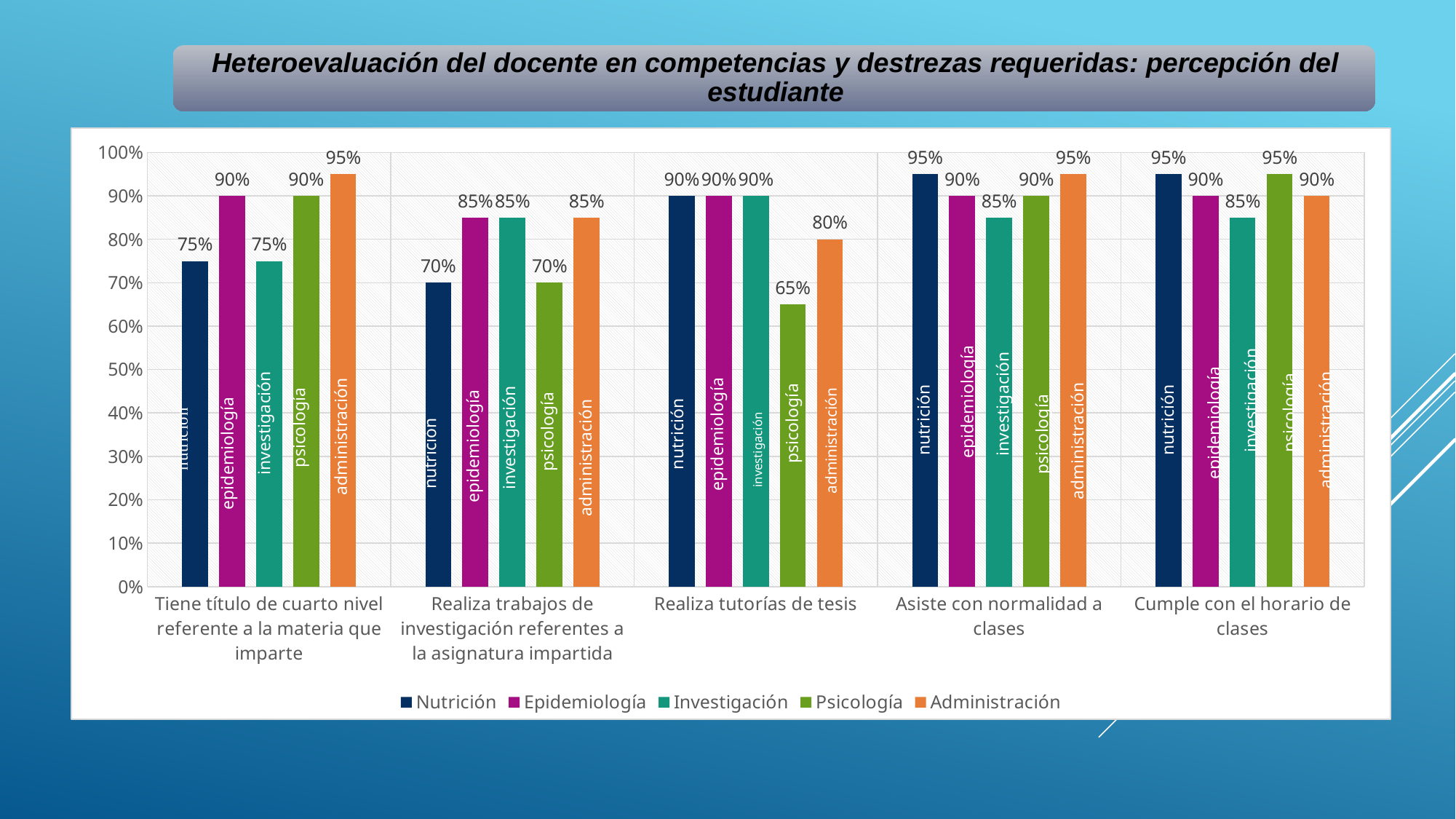
In the category 'Cumple con el horario de clases', which is larger: the value for Psicología or the value for Investigación? Psicología How many categories are shown on the x axis? 5 What is the value for Investigación in the category 'Asiste con normalidad a clases'? 85% What is the value for Nutrición in the category 'Realiza trabajos de investigación referentes a la asignatura impartida'? 70% Which series has the lowest value in the category 'Realiza tutorías de tesis'? Psicología Which series has the highest value in the category 'Tiene título de cuarto nivel referente a la materia que imparte'? Administración What is the value for Psicología in the category 'Realiza tutorías de tesis'? 65% What is the difference between the Administración and Psicología values in the category 'Realiza tutorías de tesis'? 15% What is the title of the chart on the slide? Heteroevaluación del docente en competencias y destrezas requeridas: percepción del estudiante What kind of chart is shown on the slide? Bar chart What is the value for Administración in the category 'Tiene título de cuarto nivel referente a la materia que imparte'? 95% How many series does the legend list? 5